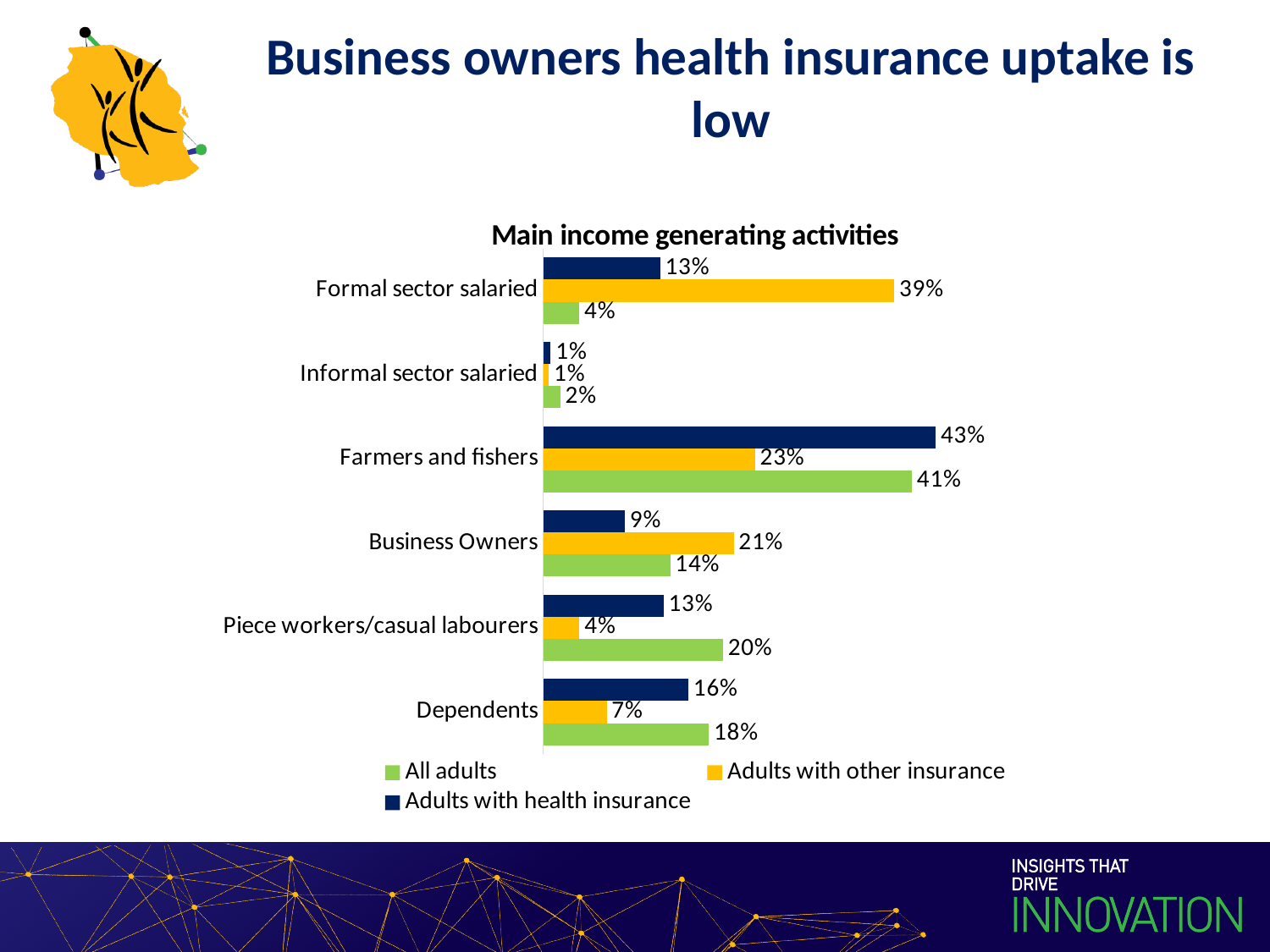
What is the difference between the 'Adults with health insurance' and 'All adults' values for Farmers and fishers? 2% For Dependents, which is larger: the 'All adults' value or the 'Adults with other insurance' value? All adults What kind of chart is shown on the slide? Bar chart How many series does the legend list? 3 What is the value for Business Owners in the 'Adults with health insurance' series? 9% What is the value for Formal sector salaried in the 'Adults with other insurance' series? 39% Which category has the highest value in the 'Adults with health insurance' series? Farmers and fishers What is the difference between the 'Adults with other insurance' and 'Adults with health insurance' values for Business Owners? 12% What is the title of the chart? Main income generating activities What is the value for Piece workers/casual labourers in the 'All adults' series? 20% How many income generating activity categories are shown on the chart? 6 Which category has the lowest value in the 'All adults' series? Informal sector salaried